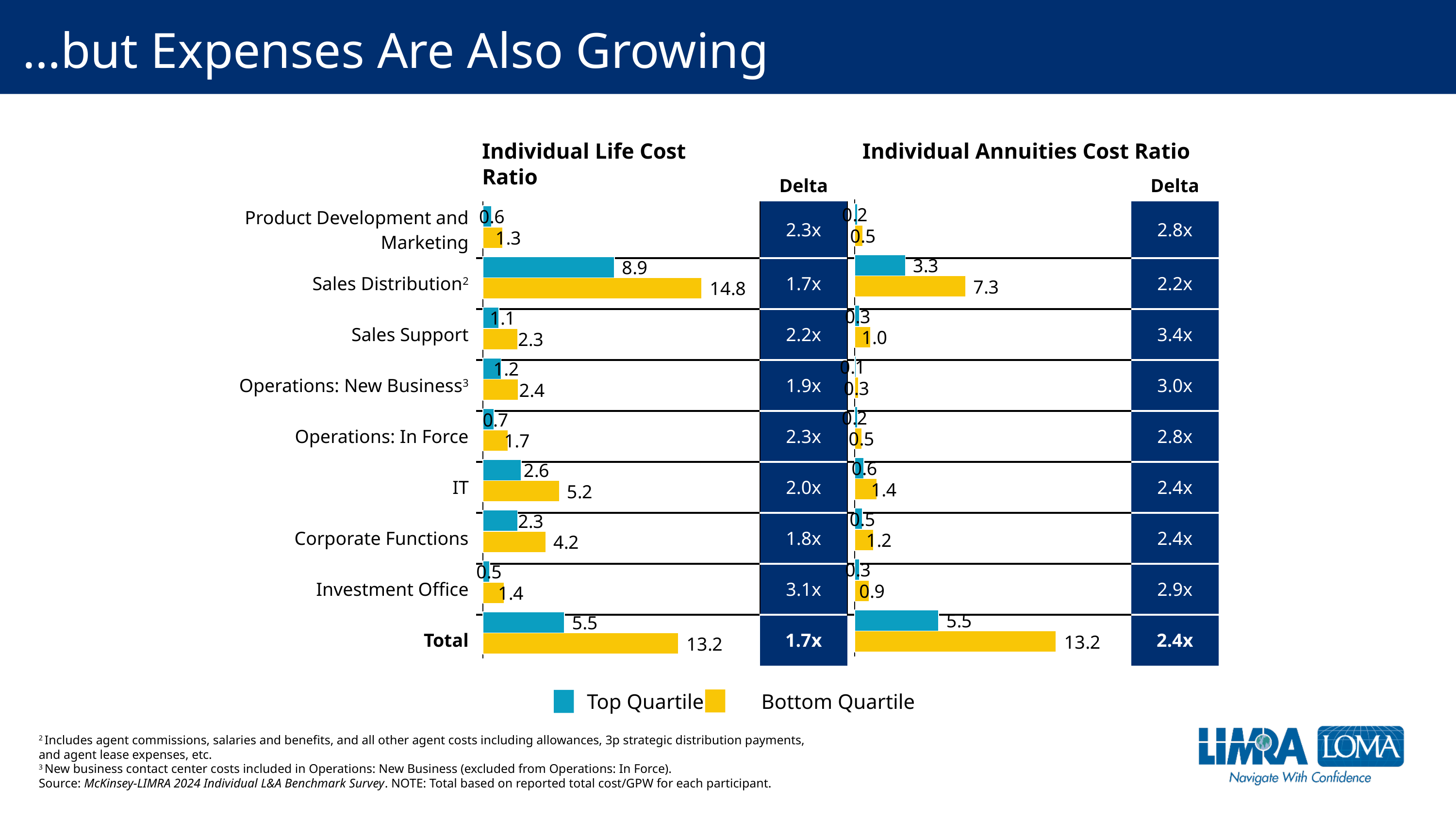
In the Individual Annuities Cost Ratio chart, what is the Top Quartile value for Sales Distribution? 3.3 In the Individual Life Cost Ratio chart, which is larger: the Bottom Quartile value for IT or the Bottom Quartile value for Corporate Functions? IT In the Individual Life Cost Ratio chart, what is the difference between the Bottom Quartile and Top Quartile values for Total? 7.7 In the Individual Life Cost Ratio chart, which category has the lowest Top Quartile value? Investment Office In the Individual Annuities Cost Ratio chart, what is the Delta shown for Sales Support? 3.4x What kind of chart is the Individual Life Cost Ratio chart? Bar chart In the Individual Annuities Cost Ratio chart, what is the difference between the Bottom Quartile and Top Quartile values for Sales Distribution? 4.0 In the Individual Life Cost Ratio chart, what is the Bottom Quartile value for Sales Distribution? 14.8 How many series does the legend list? 2 In the Individual Annuities Cost Ratio chart, what is the Bottom Quartile value for Corporate Functions? 1.2 In the Individual Life Cost Ratio chart, what is the Top Quartile value for IT? 2.6 In the Individual Life Cost Ratio chart, which category has the highest Bottom Quartile value? Sales Distribution